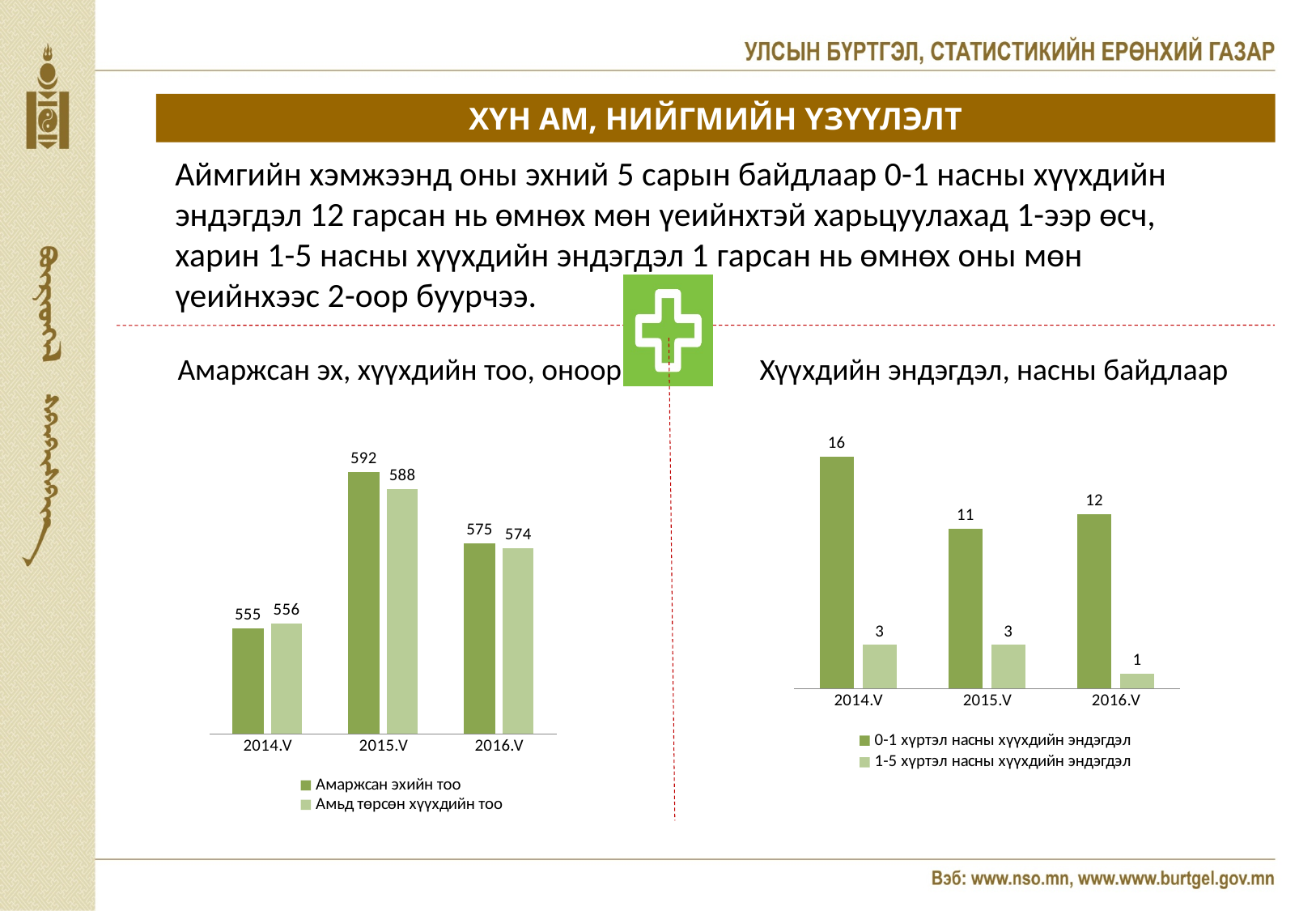
What type of chart is the right chart (Хүүхдийн эндэгдэл, насны байдлаар)? Bar chart In the right chart (Хүүхдийн эндэгдэл, насны байдлаар), what is the value of 0-1 хүртэл насны хүүхдийн эндэгдэл for 2014.V? 16 In the left chart (Амаржсан эх, хүүхдийн тоо, оноор), which year has the highest value for Амаржсан эхийн тоо? 2015.V In the left chart (Амаржсан эх, хүүхдийн тоо, оноор), is Амьд төрсөн хүүхдийн тоо in 2015.V larger or smaller than in 2016.V? Larger In the right chart (Хүүхдийн эндэгдэл, насны байдлаар), what is the difference between the 0-1 and 1-5 age group values in 2016.V? 11 In the right chart (Хүүхдийн эндэгдэл, насны байдлаар), which year has the lowest value for 0-1 хүртэл насны хүүхдийн эндэгдэл? 2015.V In the right chart (Хүүхдийн эндэгдэл, насны байдлаар), what is the value of 1-5 хүртэл насны хүүхдийн эндэгдэл for 2016.V? 1 In the left chart (Амаржсан эх, хүүхдийн тоо, оноор), how many series does the legend list? 2 In the right chart (Хүүхдийн эндэгдэл, насны байдлаар), how many year categories are shown on the x axis? 3 In the left chart (Амаржсан эх, хүүхдийн тоо, оноор), what is the difference between Амаржсан эхийн тоо in 2015.V and 2014.V? 37 In the left chart (Амаржсан эх, хүүхдийн тоо, оноор), what is the value of Амьд төрсөн хүүхдийн тоо for 2014.V? 556 In the left chart (Амаржсан эх, хүүхдийн тоо, оноор), what is the value of Амаржсан эхийн тоо for 2015.V? 592